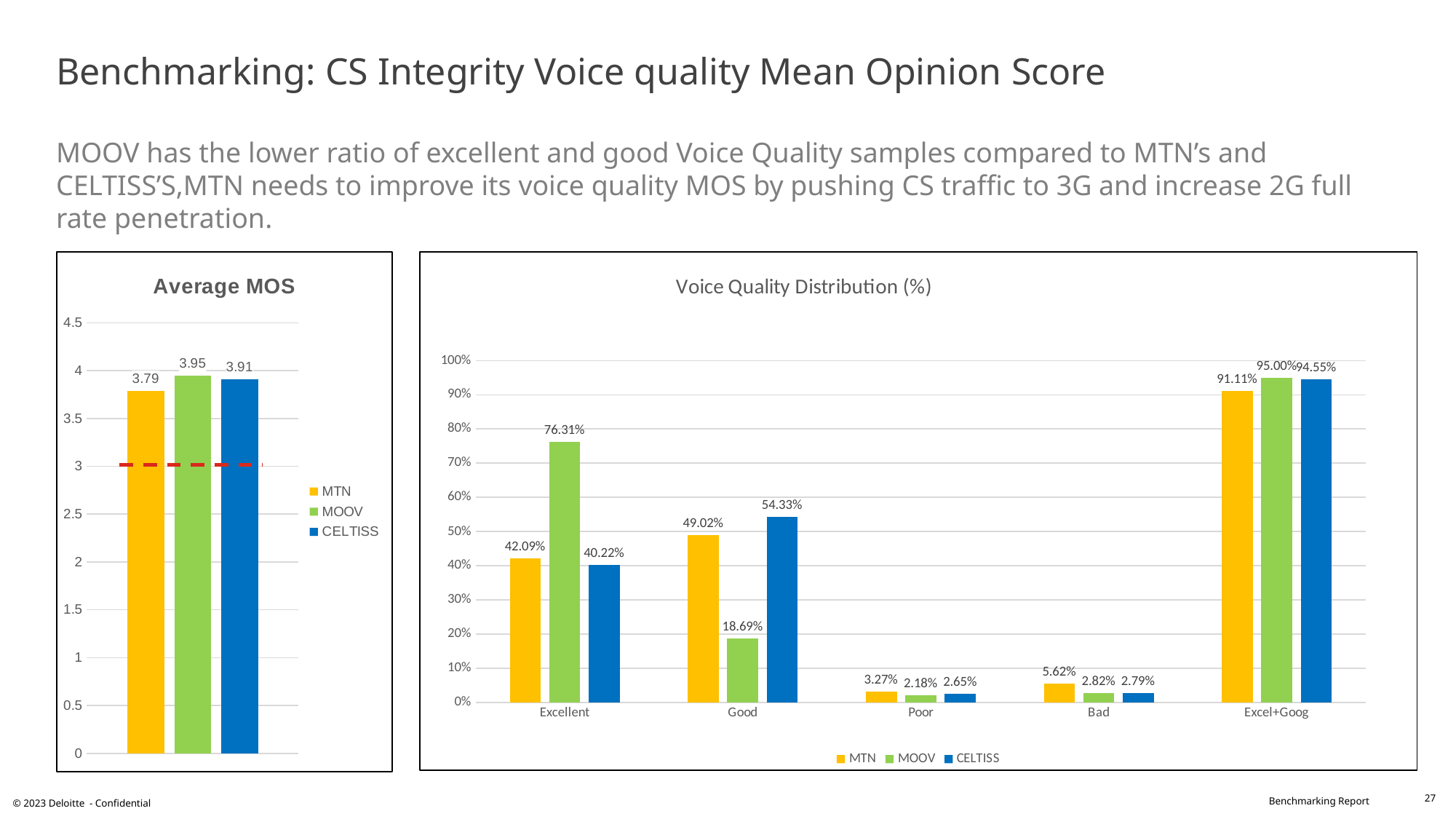
In the Average MOS chart, which operator has the highest average MOS? MOOV In the Average MOS chart, what is the value for MTN? 3.79 In the Voice Quality Distribution (%) chart, what is the value for MTN in the Poor category? 3.27% In the Voice Quality Distribution (%) chart, which operator has the lowest value in the Good category? MOOV In the Average MOS chart, how many series does the legend list? 3 In the Voice Quality Distribution (%) chart, which is larger in the Bad category: MTN or MOOV? MTN In the Voice Quality Distribution (%) chart, what is the difference between MOOV's and MTN's values in the Excel+Goog category? 3.89% In the Voice Quality Distribution (%) chart, what is the value for CELTISS in the Good category? 54.33% In the Voice Quality Distribution (%) chart, what is the value for MOOV in the Excellent category? 76.31% In the Voice Quality Distribution (%) chart, how many categories are shown on the x axis? 5 In the Average MOS chart, what is the difference between MOOV's and MTN's values? 0.16 What kind of chart is the Voice Quality Distribution (%) chart? Bar chart